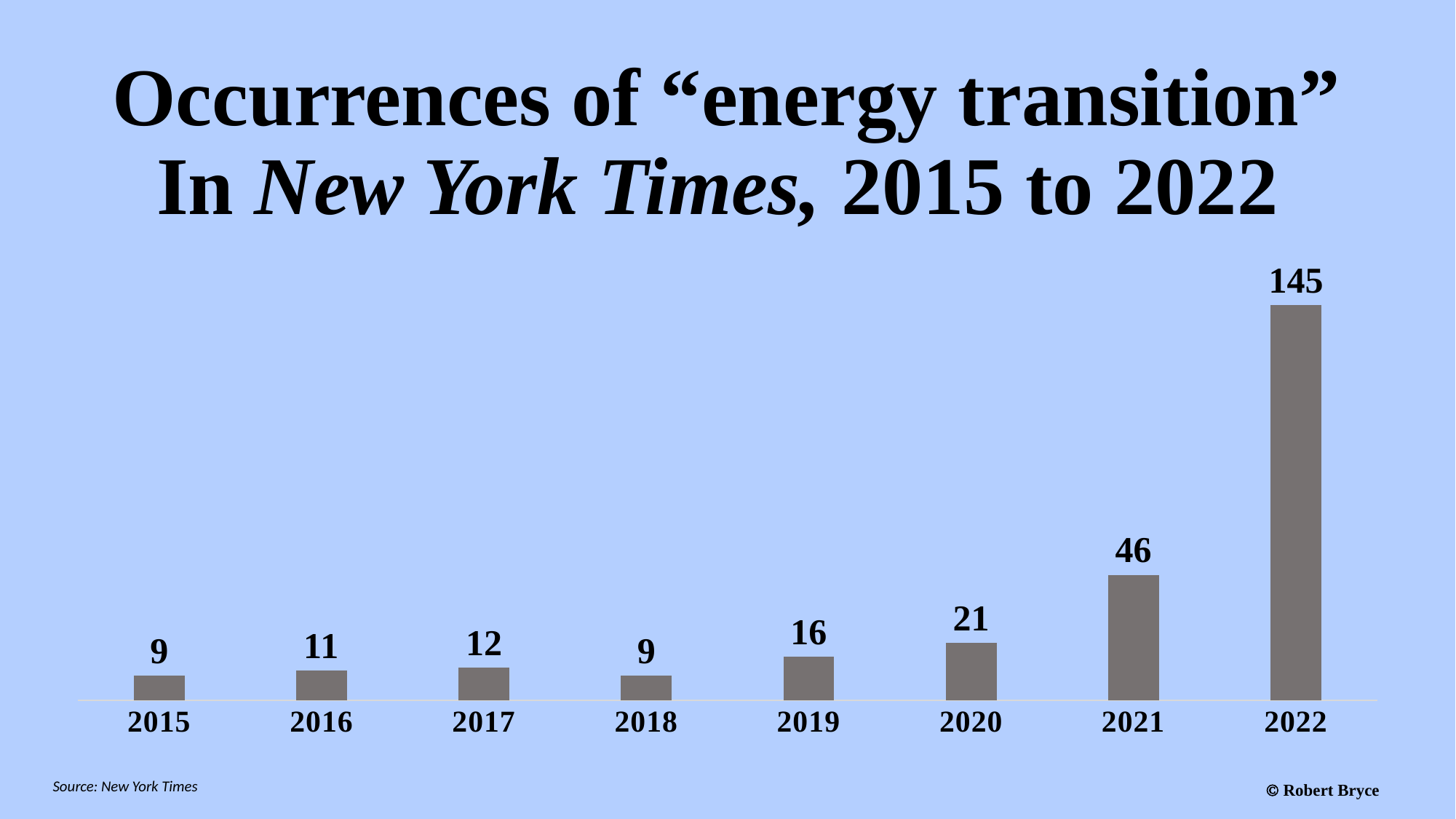
What is the value for 2018? 9 Which year has the highest value? 2022 What is the value for 2021? 46 What is the source cited at the bottom of the slide? New York Times Which is larger, the value for 2016 or the value for 2017? 2017 What is the difference between the values for 2022 and 2021? 99 What is the value for 2022? 145 How many years are shown on the x axis? 8 What is the value for 2020? 21 Do the values generally rise or fall from 2018 to 2022? Rise What kind of chart is this? Bar chart What is the difference between the values for 2019 and 2017? 4